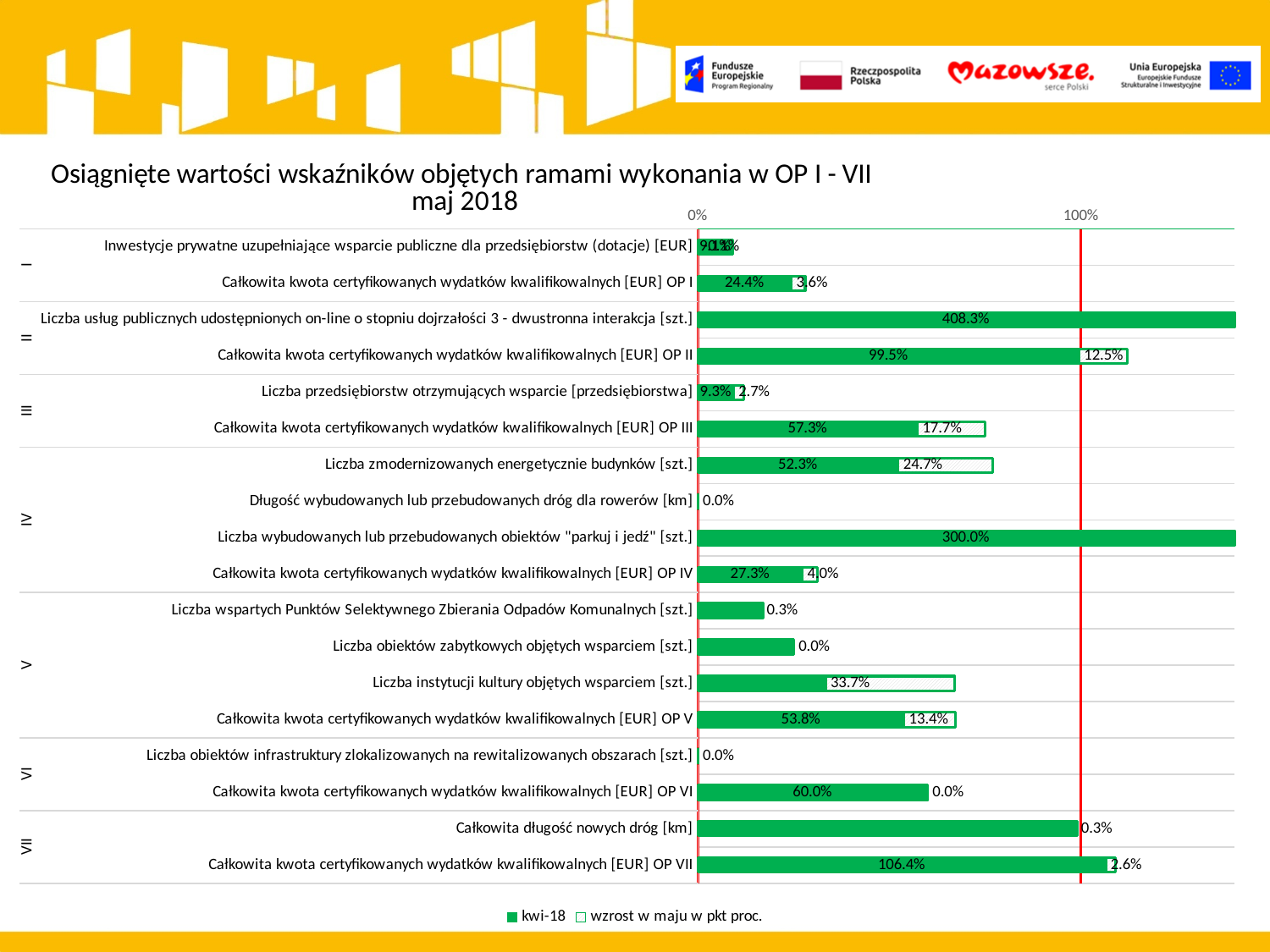
What is the kwi-18 value for 'Całkowita kwota certyfikowanych wydatków kwalifikowalnych [EUR] OP II'? 99.5% How many series does the chart legend list? 2 What kind of chart is shown on the slide? bar chart What is the difference between the kwi-18 values for 'Całkowita kwota certyfikowanych wydatków kwalifikowalnych [EUR] OP II' and 'Całkowita kwota certyfikowanych wydatków kwalifikowalnych [EUR] OP I'? 75.1% Which category has the highest kwi-18 value? Liczba usług publicznych udostępnionych on-line o stopniu dojrzałości 3 - dwustronna interakcja [szt.] (408.3%) What is the 'wzrost w maju w pkt proc.' value for 'Liczba zmodernizowanych energetycznie budynków [szt.]'? 24.7% What is the 'wzrost w maju w pkt proc.' value for 'Całkowita kwota certyfikowanych wydatków kwalifikowalnych [EUR] OP III'? 17.7% What is the total of the stacked bar for 'Całkowita kwota certyfikowanych wydatków kwalifikowalnych [EUR] OP II'? 112.0% What are the two legend entries of the chart? kwi-18 and wzrost w maju w pkt proc. What is the kwi-18 value for 'Liczba wybudowanych lub przebudowanych obiektów "parkuj i jedź" [szt.]'? 300.0% Is the kwi-18 value for 'Liczba obiektów zabytkowych objętych wsparciem [szt.]' greater or less than 100%? less How many indicator categories are plotted on the chart? 18